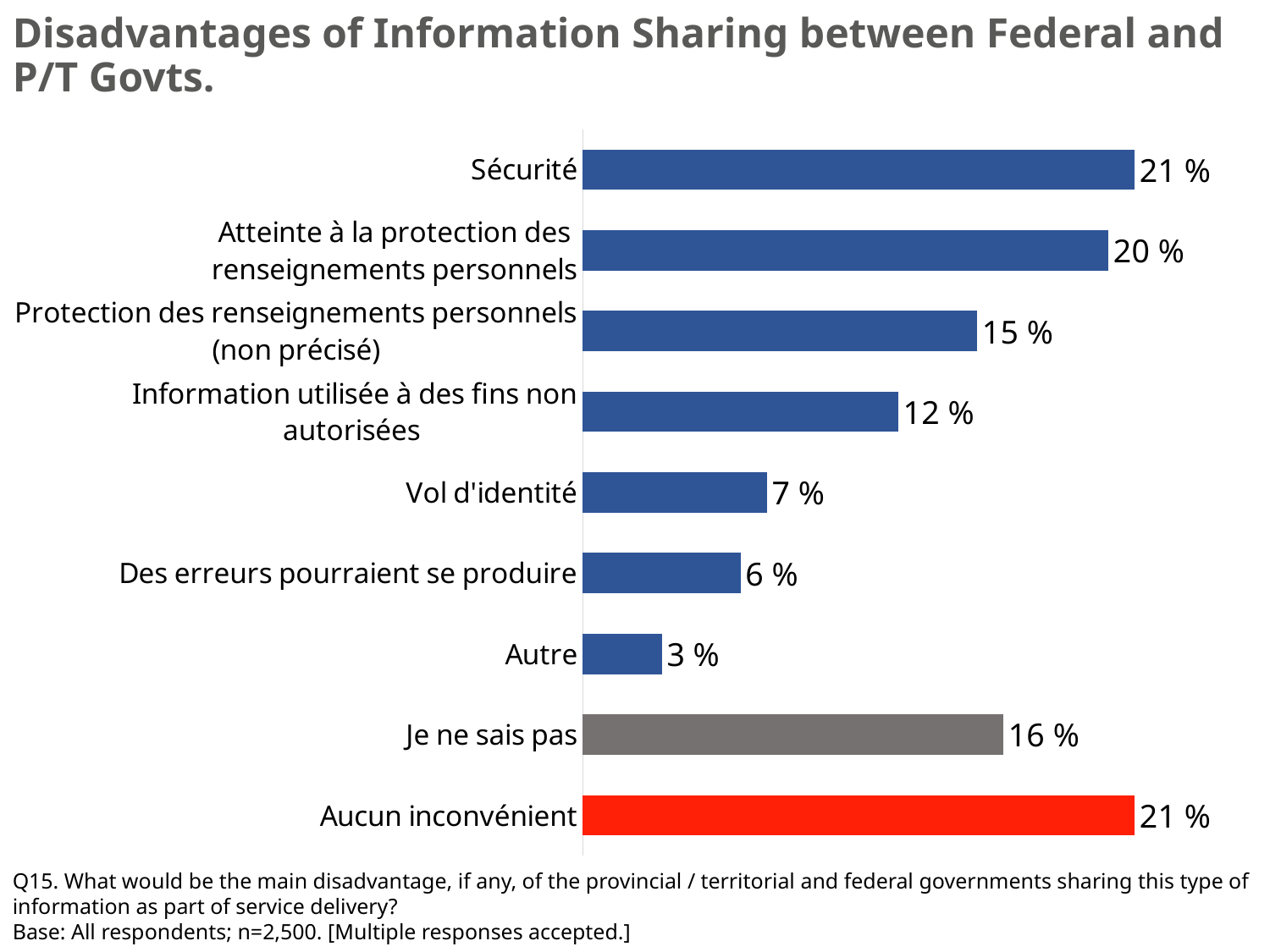
Which category has the lowest value? Autre What is the value for Information utilisée à des fins non autorisées? 12 % What is the difference between the values for Atteinte à la protection des renseignements personnels and Protection des renseignements personnels (non précisé)? 5 % What is the value for Sécurité? 21 % Which is larger, the value for Je ne sais pas or the value for Information utilisée à des fins non autorisées? Je ne sais pas What is the value for Vol d'identité? 7 % How many categories are shown in the chart? 9 What is the value for Je ne sais pas? 16 % What kind of chart is shown on the slide? Bar chart What is the difference between the values for Je ne sais pas and Des erreurs pourraient se produire? 10 % Which is larger, the value for Vol d'identité or the value for Des erreurs pourraient se produire? Vol d'identité Which bar is coloured red? Aucun inconvénient